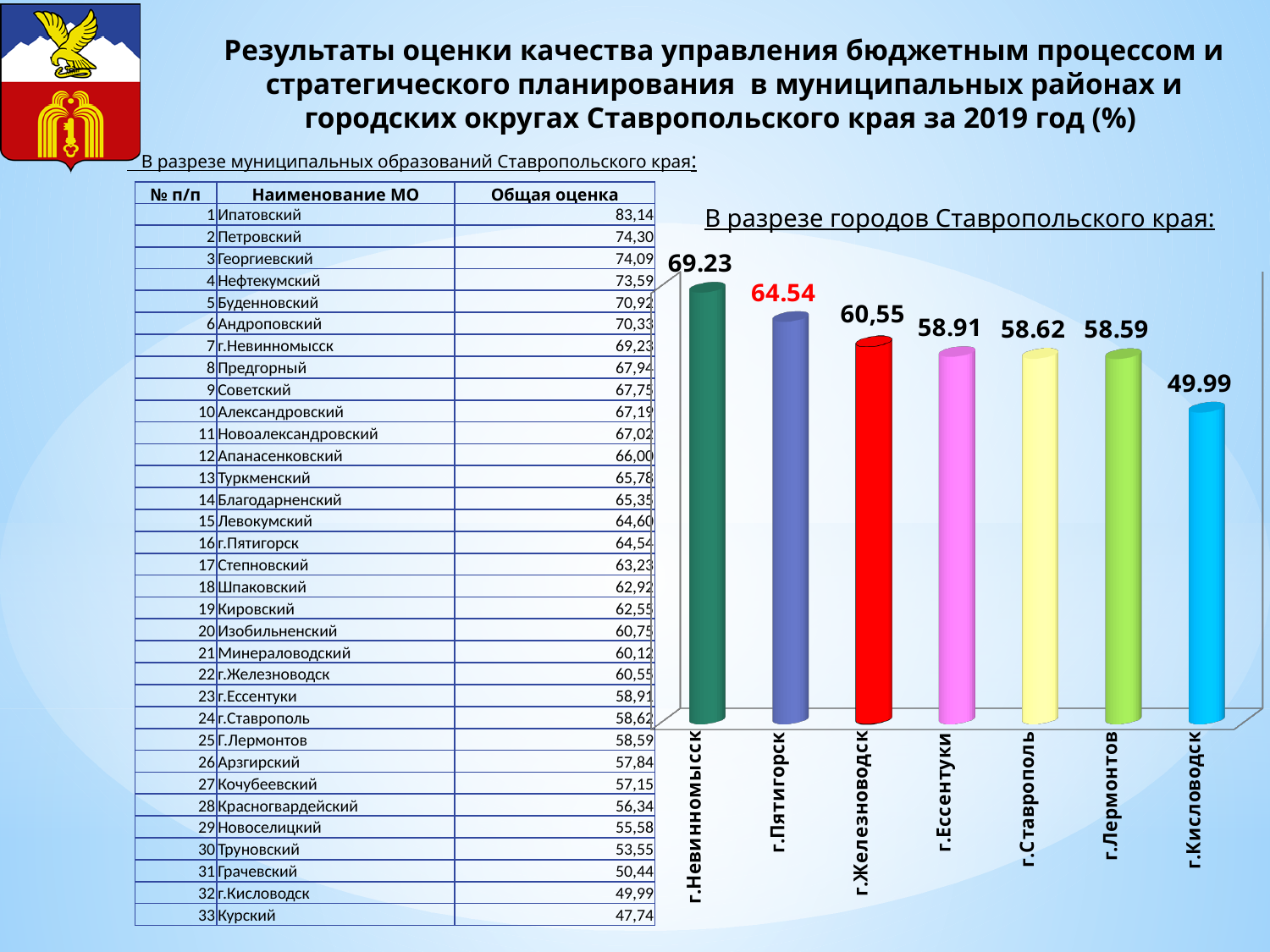
Which city has the highest value in the chart? г.Невинномысск What is the value shown for г.Железноводск? 60,55 What is the heading written above the chart? В разрезе городов Ставропольского края: What is the value shown for г.Кисловодск? 49.99 What is the value shown for г.Невинномысск? 69.23 Do the values rise or fall from left to right across the chart? fall What is the value shown for г.Пятигорск? 64.54 Which city has the lowest value in the chart? г.Кисловодск What type of chart is shown on the slide? bar chart How many cities are plotted in the chart? 7 Which has a larger value, г.Пятигорск or г.Ессентуки? г.Пятигорск What is the difference between the values for г.Невинномысск and г.Кисловодск? 19.24